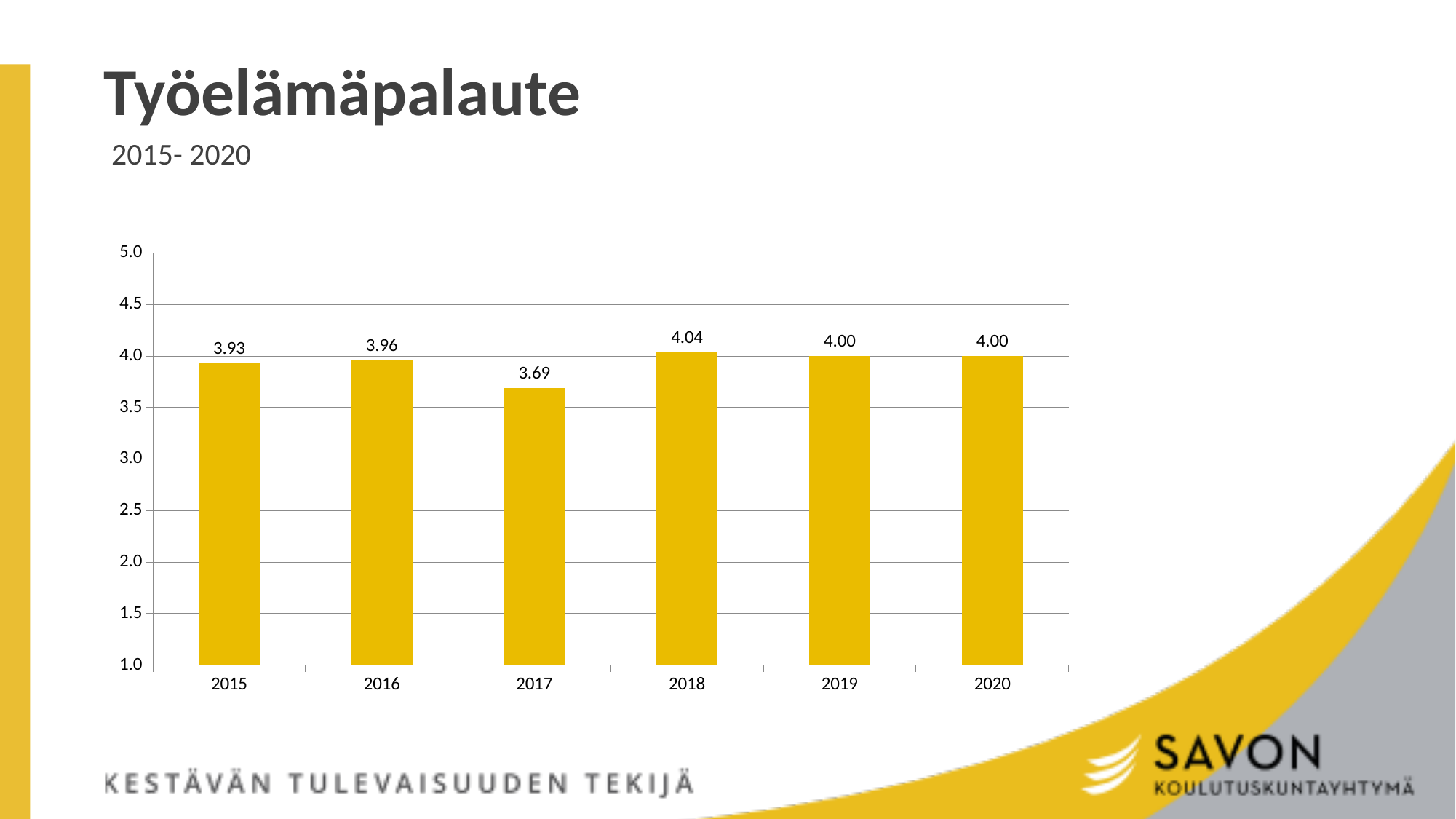
Which year has the lowest value? 2017 Which is larger, the value for 2016 or the value for 2017? 2016 What is the value for 2017? 3.69 What is the value for 2015? 3.93 What is the title of the slide? Työelämäpalaute What is the difference between the values for 2016 and 2015? 0.03 What kind of chart is shown on the slide? bar chart What is the value for 2018? 4.04 What is the difference between the values for 2018 and 2017? 0.35 Is the value for 2017 greater or less than 4.0? less How many years are shown on the x axis? 6 Which year has the highest value? 2018